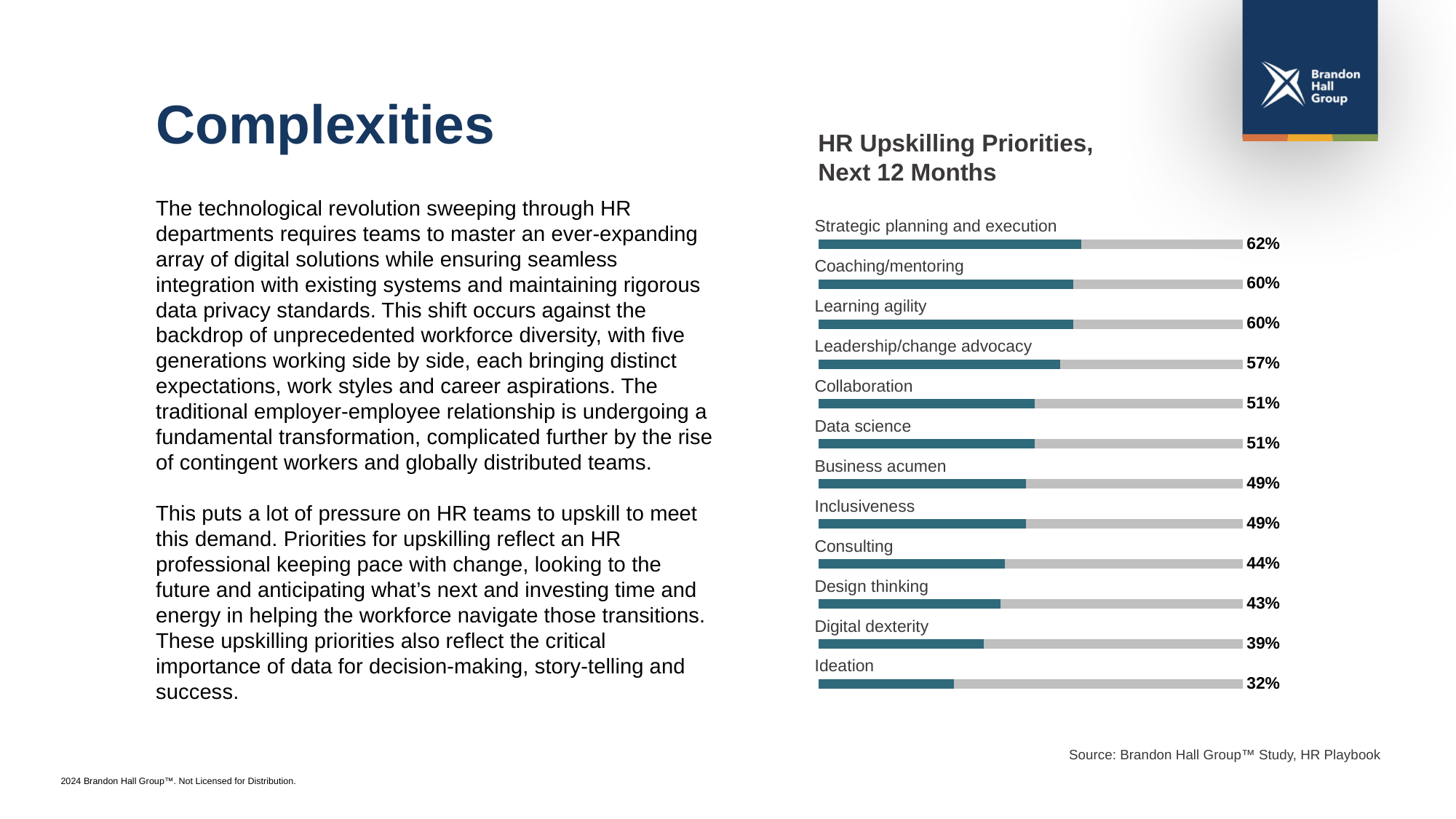
What is the value for Digital dexterity? 39% Which category has the lowest value? Ideation Which category has the highest value? Strategic planning and execution What is the difference between Consulting and Design thinking? 1 percentage point What is the value for Strategic planning and execution? 62% What is the title of the chart? HR Upskilling Priorities, Next 12 Months What is the value for Leadership/change advocacy? 57% How many categories are shown in the chart? 12 What is the difference between Strategic planning and execution and Ideation? 30 percentage points Which is larger, Collaboration or Business acumen? Collaboration Which is larger, Digital dexterity or Consulting? Consulting What kind of chart is shown on the slide? Bar chart